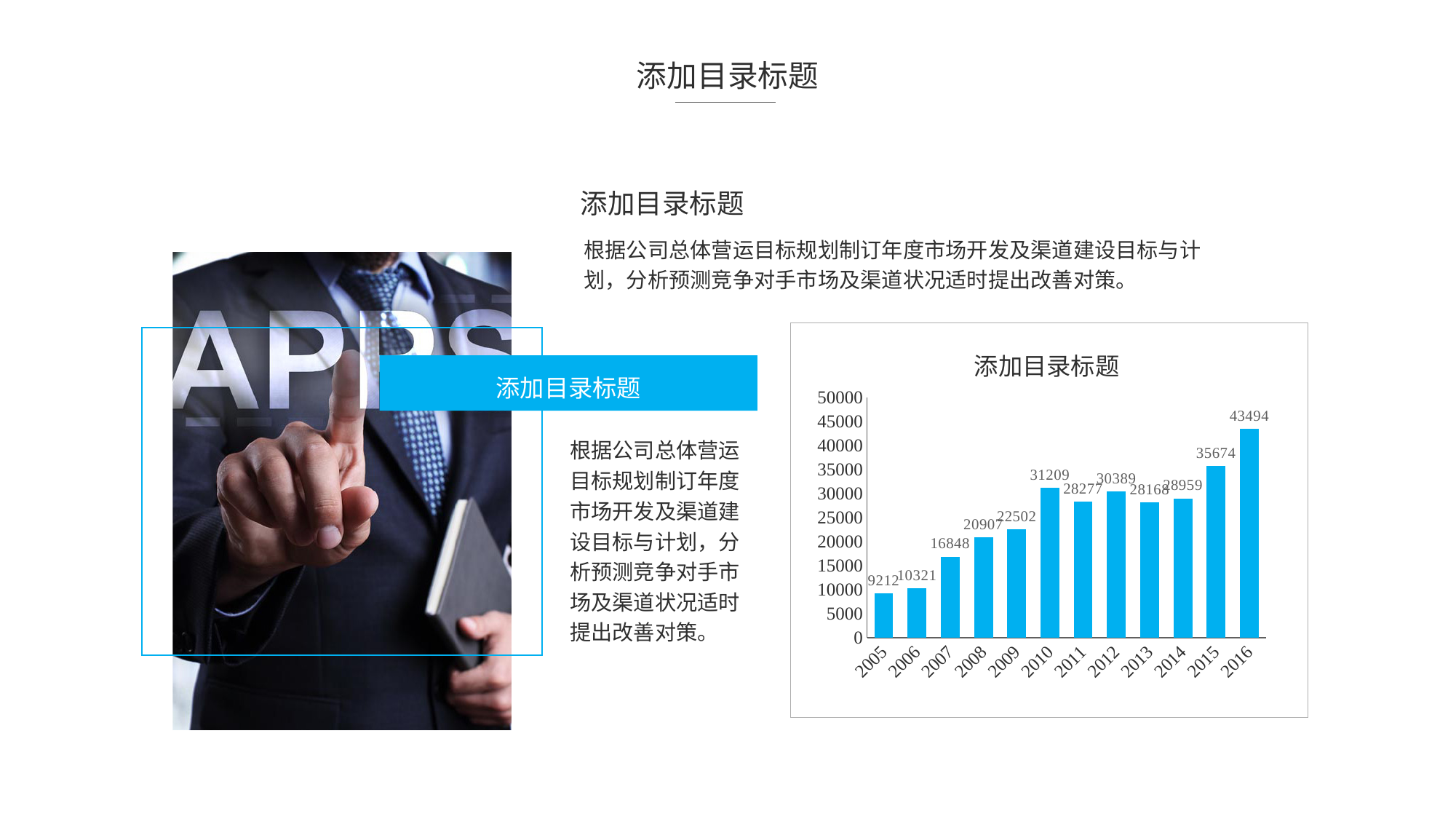
How many years are shown on the x axis? 12 What is the difference between the values for 2016 and 2015? 7820 Which is larger, the value for 2010 or the value for 2012? 2010 Is the value for 2009 greater or less than 25000? less What is the value for 2010? 31209 What is the value for 2005? 9212 What is the title of the chart? 添加目录标题 What kind of chart is shown on the slide? bar chart What is the difference between the values for 2007 and 2006? 6527 Which year has the lowest value? 2005 Which year has the highest value? 2016 What is the value for 2013? 28168